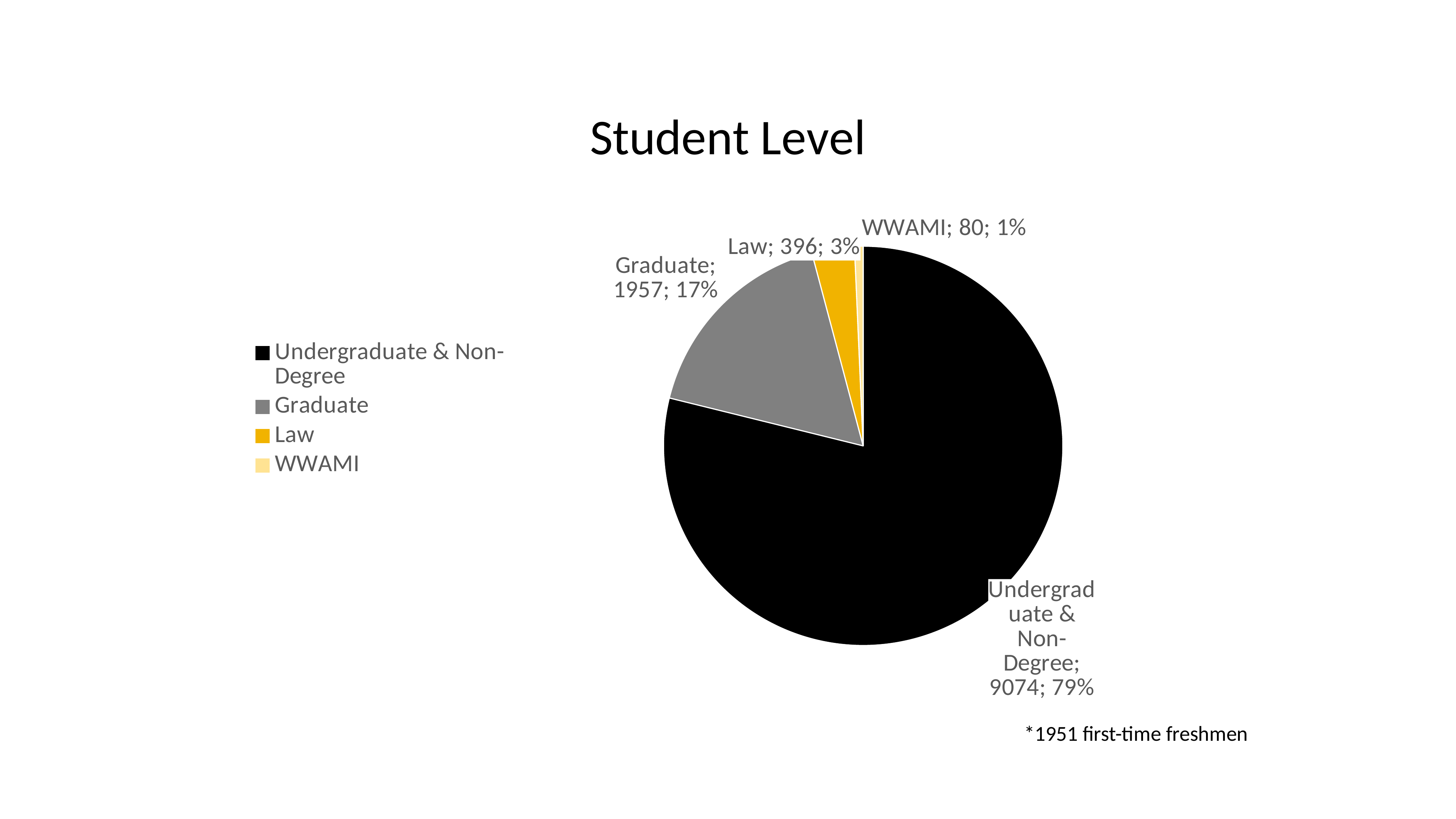
How many slices does the pie chart have? 4 How many entries does the legend list? 4 What type of chart is shown on the slide? pie chart What is the value for WWAMI? 80 What is the value for Graduate? 1957 Which category has the largest slice? Undergraduate & Non-Degree What is the value for Law? 396 What is the title of the chart? Student Level Which category has the smallest slice? WWAMI What is the value for Undergraduate & Non-Degree? 9074 What share of the pie does Graduate represent? 17% What is the difference between the Graduate and Law values? 1561